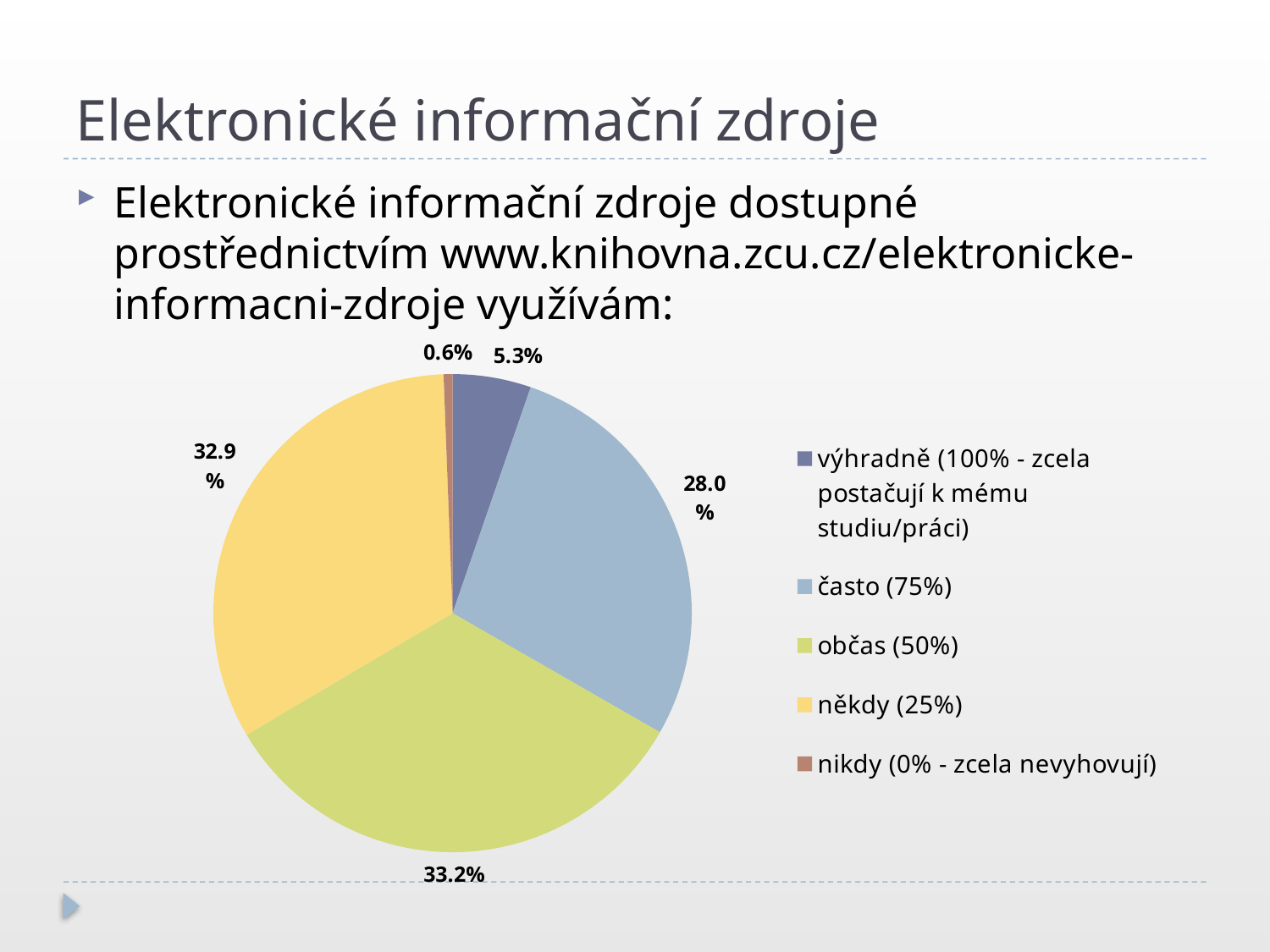
What share of the pie does "občas (50%)" have? 33.2% What share of the pie does "nikdy (0% - zcela nevyhovují)" have? 0.6% Which category has the smallest slice of the pie? nikdy (0% - zcela nevyhovují) How many slices does the pie chart have? 5 What share of the pie does "někdy (25%)" have? 32.9% What colour is the slice for "někdy (25%)"? yellow Which category has the largest slice of the pie? občas (50%) Which is larger, the slice for "často (75%)" or the slice for "někdy (25%)"? někdy (25%) What is the difference in percentage points between the "občas (50%)" slice and the "často (75%)" slice? 5.2 What kind of chart is shown on the slide? pie chart